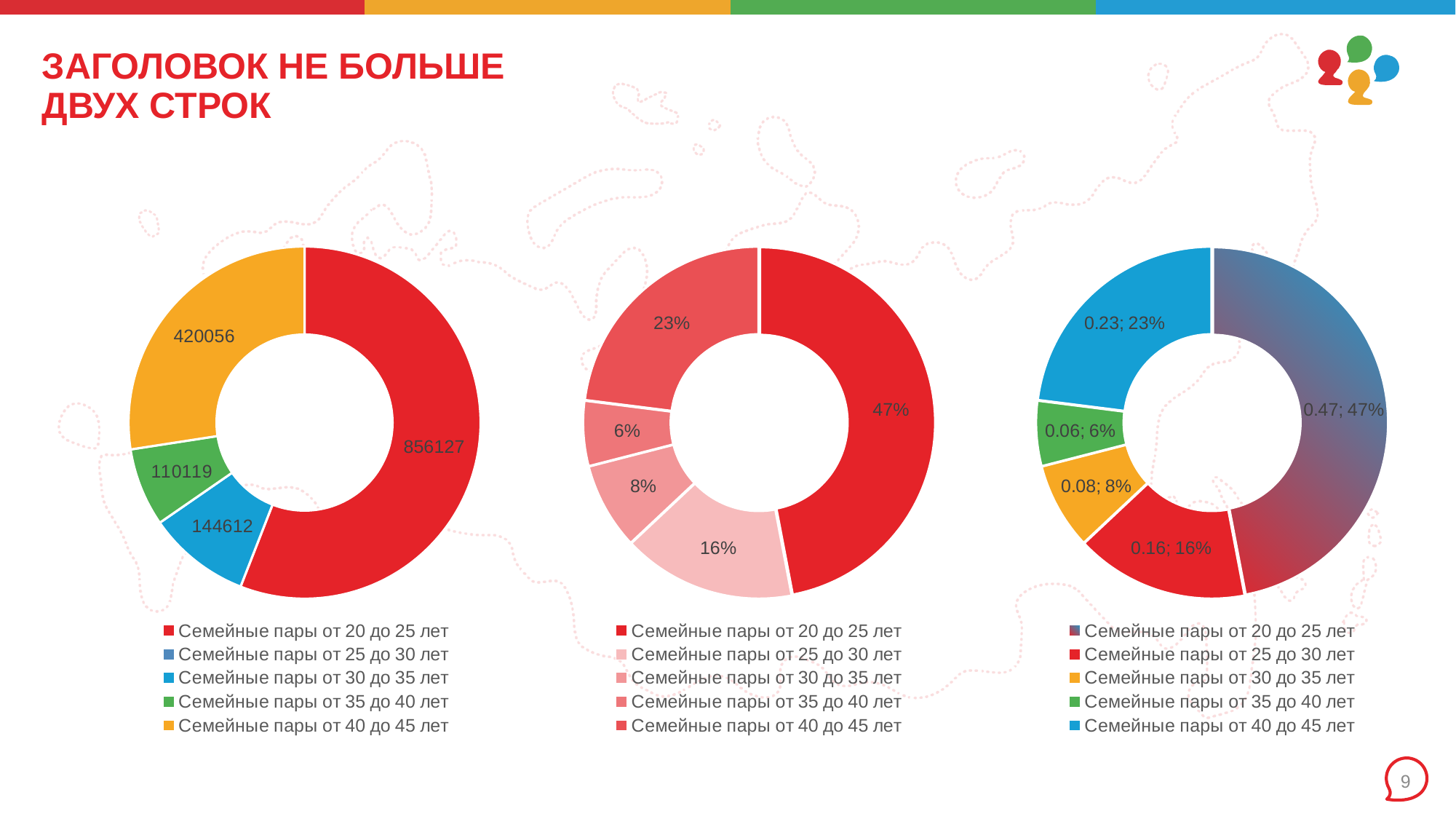
In the left chart, what is the difference between the values for Семейные пары от 30 до 35 лет and Семейные пары от 35 до 40 лет? 34493 In the left chart, which category has the largest value? Семейные пары от 20 до 25 лет In the left chart, which is larger: the value for Семейные пары от 30 до 35 лет or for Семейные пары от 35 до 40 лет? Семейные пары от 30 до 35 лет In the middle chart, what is the difference between the shares for Семейные пары от 40 до 45 лет and Семейные пары от 25 до 30 лет? 7% In the middle chart, what share does Семейные пары от 20 до 25 лет have? 47% What type of chart is the right chart? Doughnut chart In the middle chart, which category has the smallest share? Семейные пары от 35 до 40 лет How many slices does the middle chart have? 5 In the right chart, what is the data label for Семейные пары от 40 до 45 лет? 0.23; 23% In the left chart, what is the value for Семейные пары от 20 до 25 лет? 856127 In the middle chart, what is the value for Семейные пары от 40 до 45 лет? 23% In the left chart, what is the value for Семейные пары от 40 до 45 лет? 420056